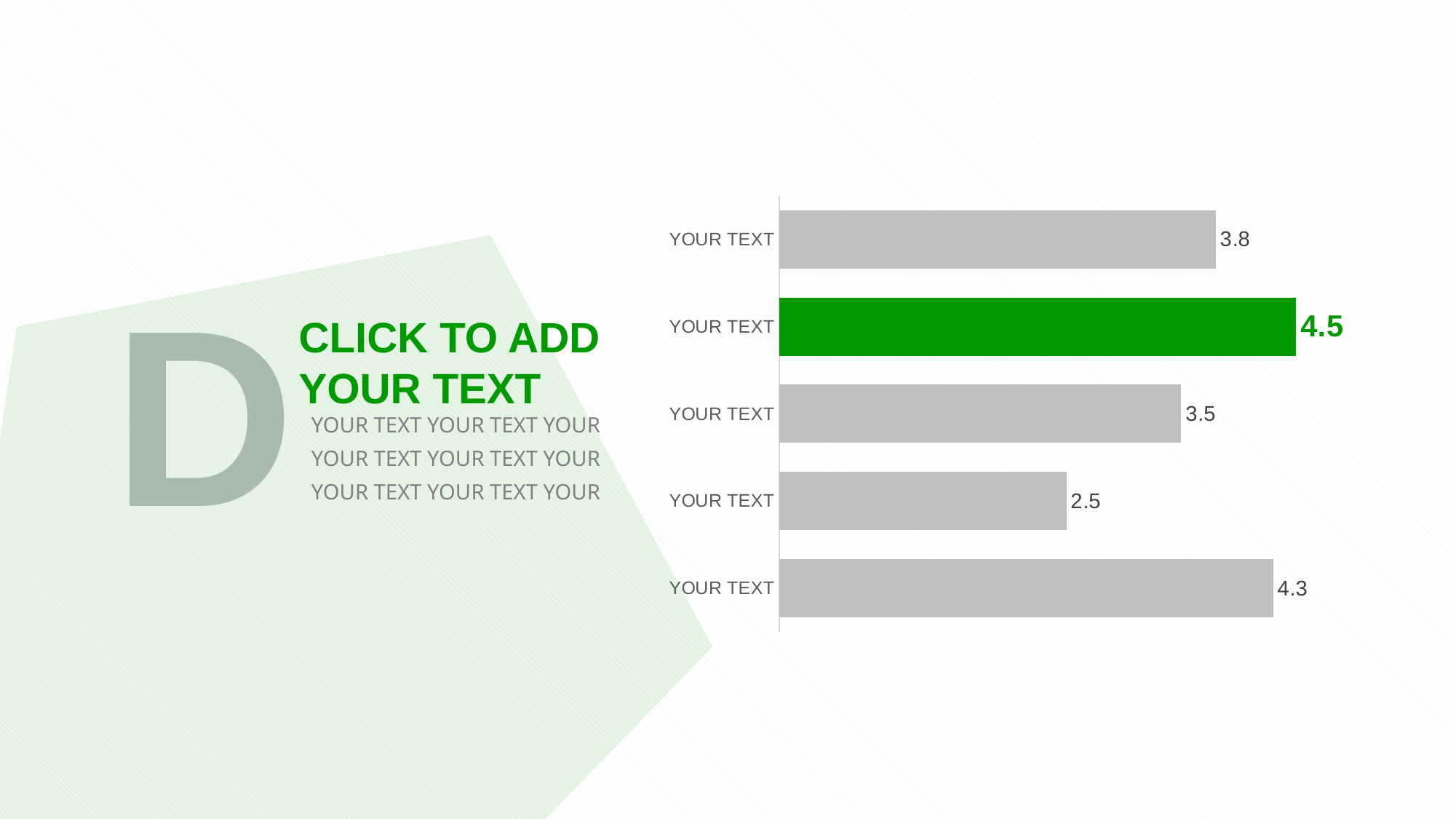
What is the value of the fourth bar from the top? 2.5 What is the value of the bottom bar in the chart? 4.3 What type of chart is shown on the slide? bar chart What is the highest value shown in the chart? 4.5 What is the difference between the green bar's value and the bottom bar's value? 0.2 What is the value of the top bar in the chart? 3.8 How many bars does the chart show? 5 Which bar in the chart is highlighted in green? the second bar from the top (4.5) What is the difference between the top bar's value and the fourth bar's value? 1.3 What is the lowest value shown in the chart? 2.5 Which is larger, the value of the top bar or the value of the third bar from the top? the top bar (3.8) What is the value of the green bar (second from the top)? 4.5